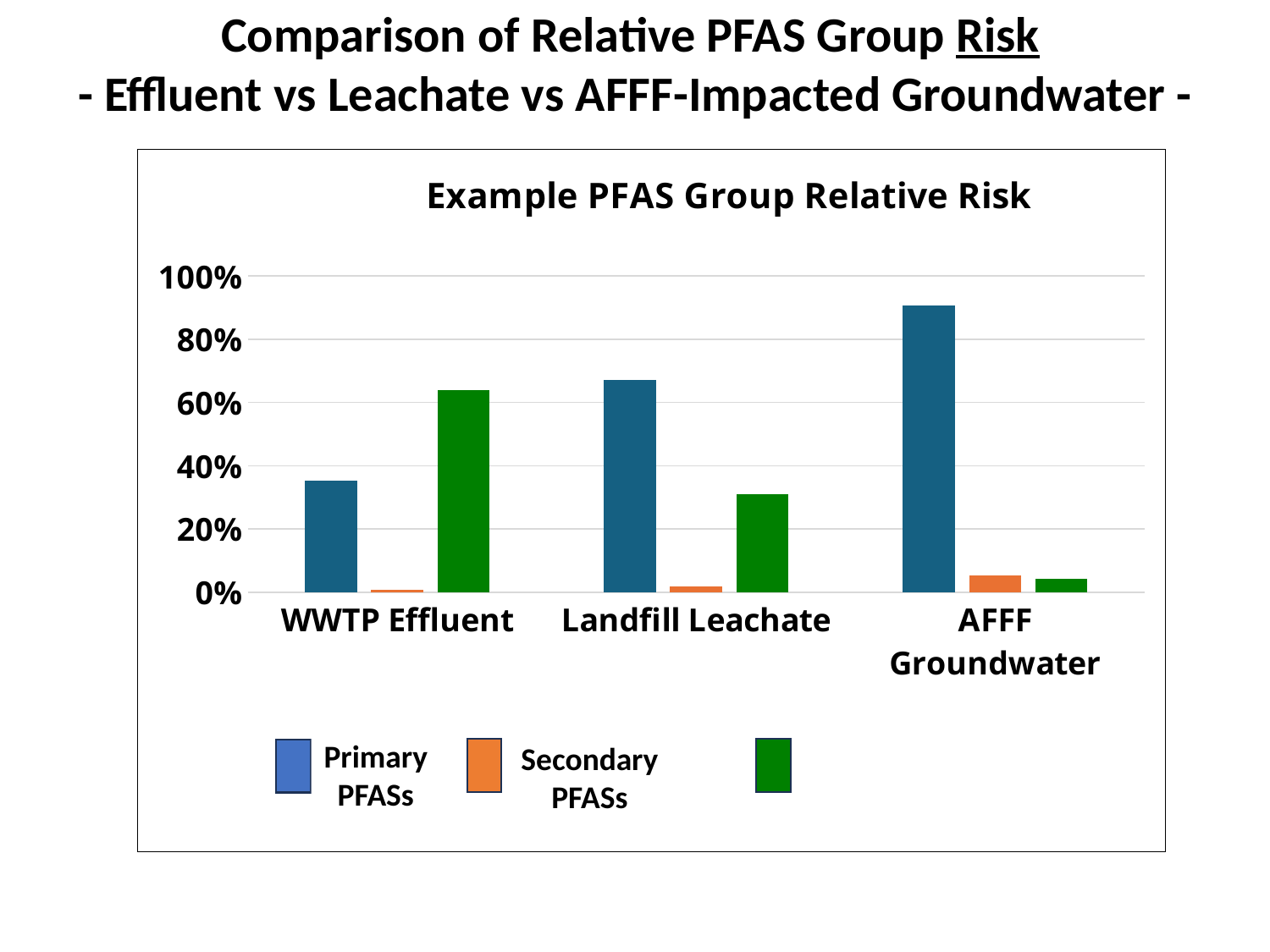
Which category has the lowest value for Primary PFASs? WWTP Effluent Is the value for Primary PFASs in Landfill Leachate greater or less than 60%? greater Is the value for Secondary PFASs in AFFF Groundwater greater or less than 20%? less How many series does the chart's legend list? 3 Which is larger: Primary PFASs in Landfill Leachate or Primary PFASs in WWTP Effluent? Primary PFASs in Landfill Leachate How many categories are shown on the x axis of the chart? 3 What is the title of the chart? Example PFAS Group Relative Risk Which category has the highest value for Primary PFASs? AFFF Groundwater Is the value for Primary PFASs in AFFF Groundwater greater or less than 80%? greater What kind of chart is shown on the slide? bar chart Do the Primary PFASs values rise or fall from WWTP Effluent to AFFF Groundwater along the x axis? rise